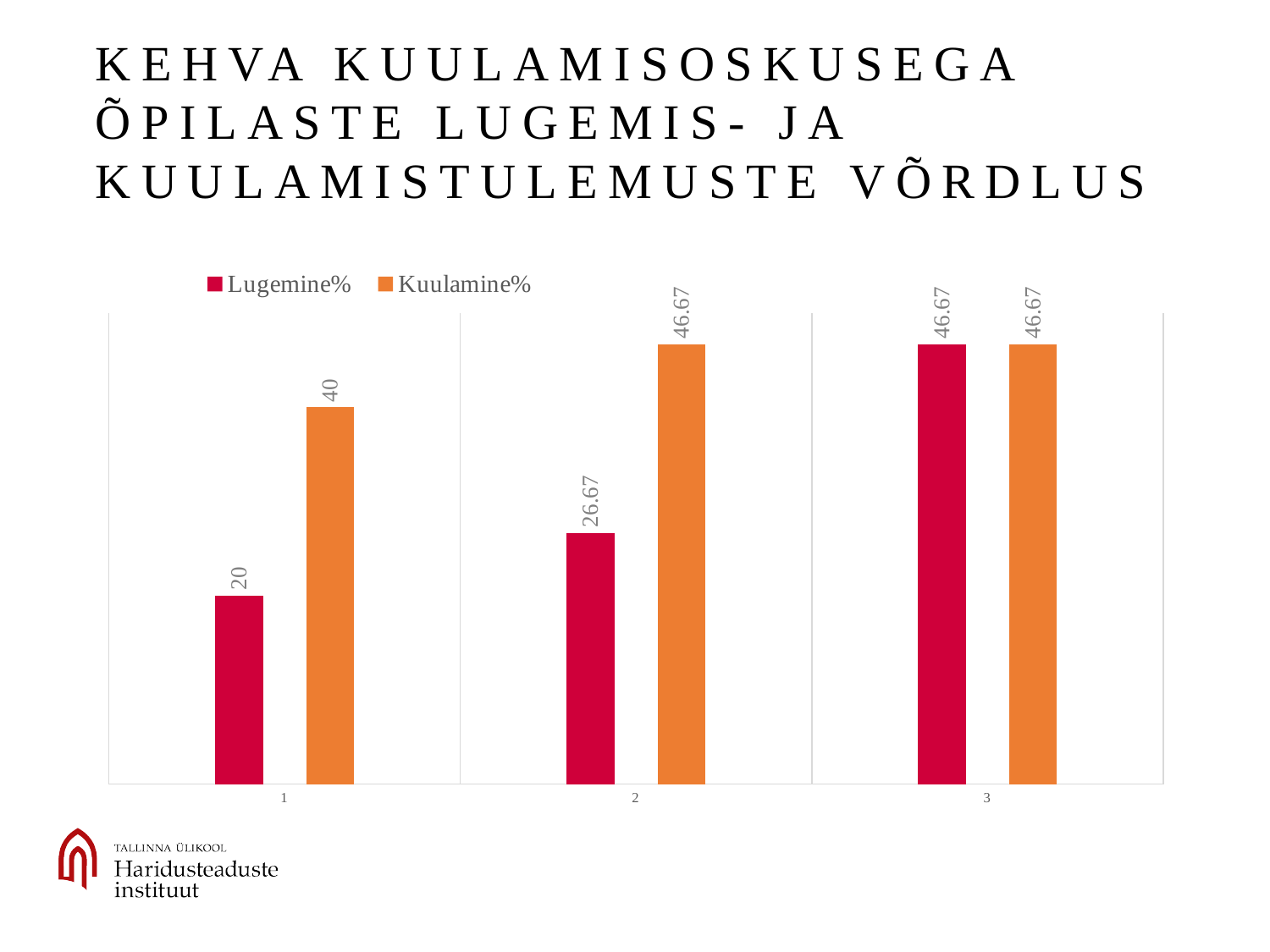
What kind of chart is shown on the slide? Bar chart What is the Lugemine% value for category 3? 46.67 For category 2, which is larger: Lugemine% or Kuulamine%? Kuulamine% How many categories are shown on the x axis? 3 Which category has the highest Lugemine% value? 3 What is the Kuulamine% value for category 2? 46.67 How many series does the legend list? 2 What is the Lugemine% value for category 1? 20 What is the Kuulamine% value for category 1? 40 Which category has the lowest Lugemine% value? 1 What is the difference between the Kuulamine% and Lugemine% values for category 2? 20 What is the difference between the Kuulamine% and Lugemine% values for category 1? 20